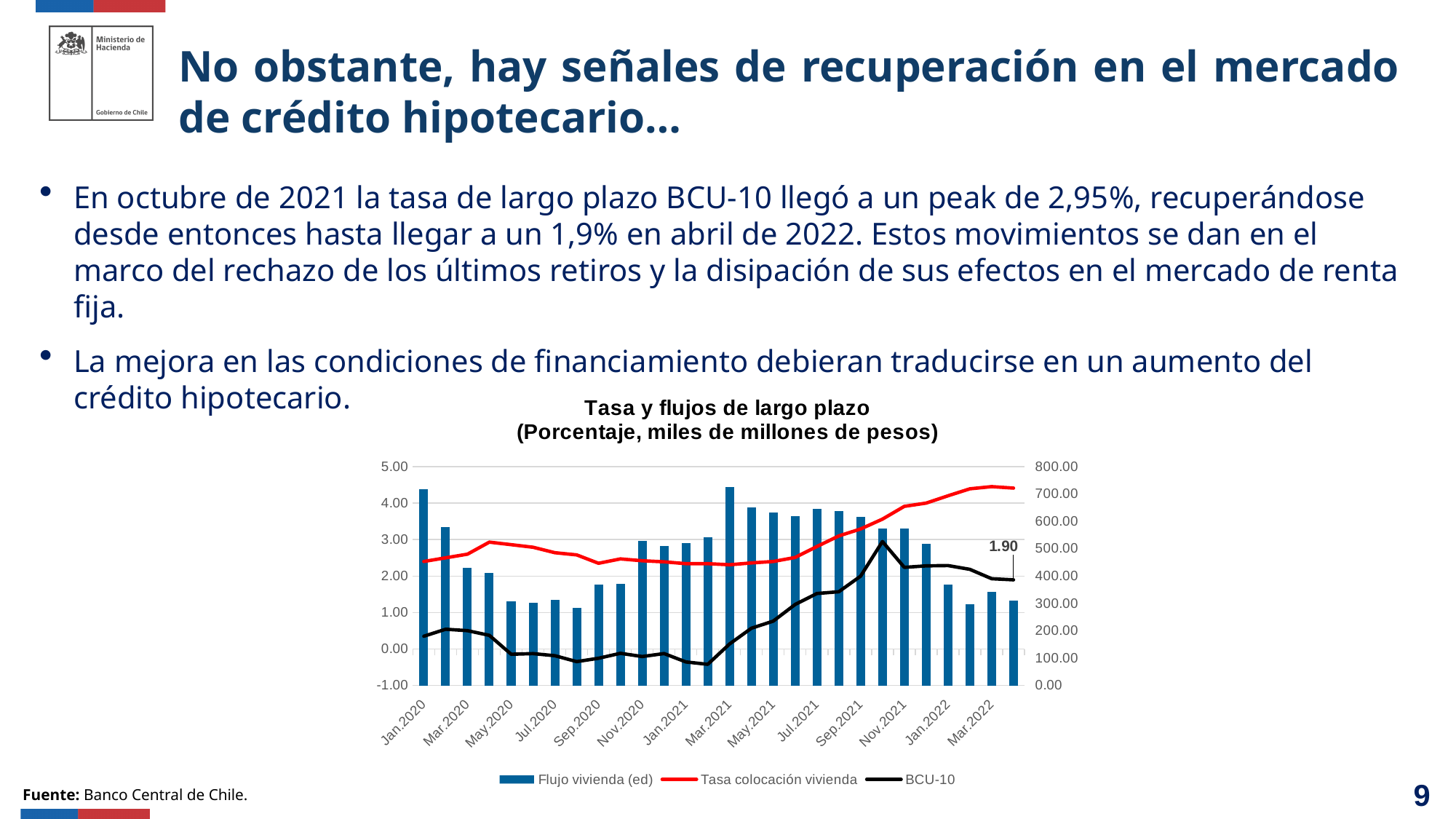
What kind of chart is shown on the slide? A combined bar and line chart How many series does the chart legend list? 3 Which is larger, the Flujo vivienda (ed) bar for Jan.2020 or for Jan.2022? Jan.2020 In Jan.2020, which line is higher, Tasa colocación vivienda or BCU-10? Tasa colocación vivienda Is the Flujo vivienda (ed) bar for Jan.2020 greater or less than 600.00 on the right axis? greater Is the BCU-10 value in Jan.2020 greater or less than 1.00? less What is the labelled value of the BCU-10 line at its last point in the chart? 1.90 What is the title of the chart? Tasa y flujos de largo plazo (Porcentaje, miles de millones de pesos) Is the Flujo vivienda (ed) bar for Sep.2020 greater or less than 400.00 on the right axis? less Which series is plotted as bars in the chart? Flujo vivienda (ed) Does the Tasa colocación vivienda line rise or fall from Sep.2021 to Mar.2022? rise